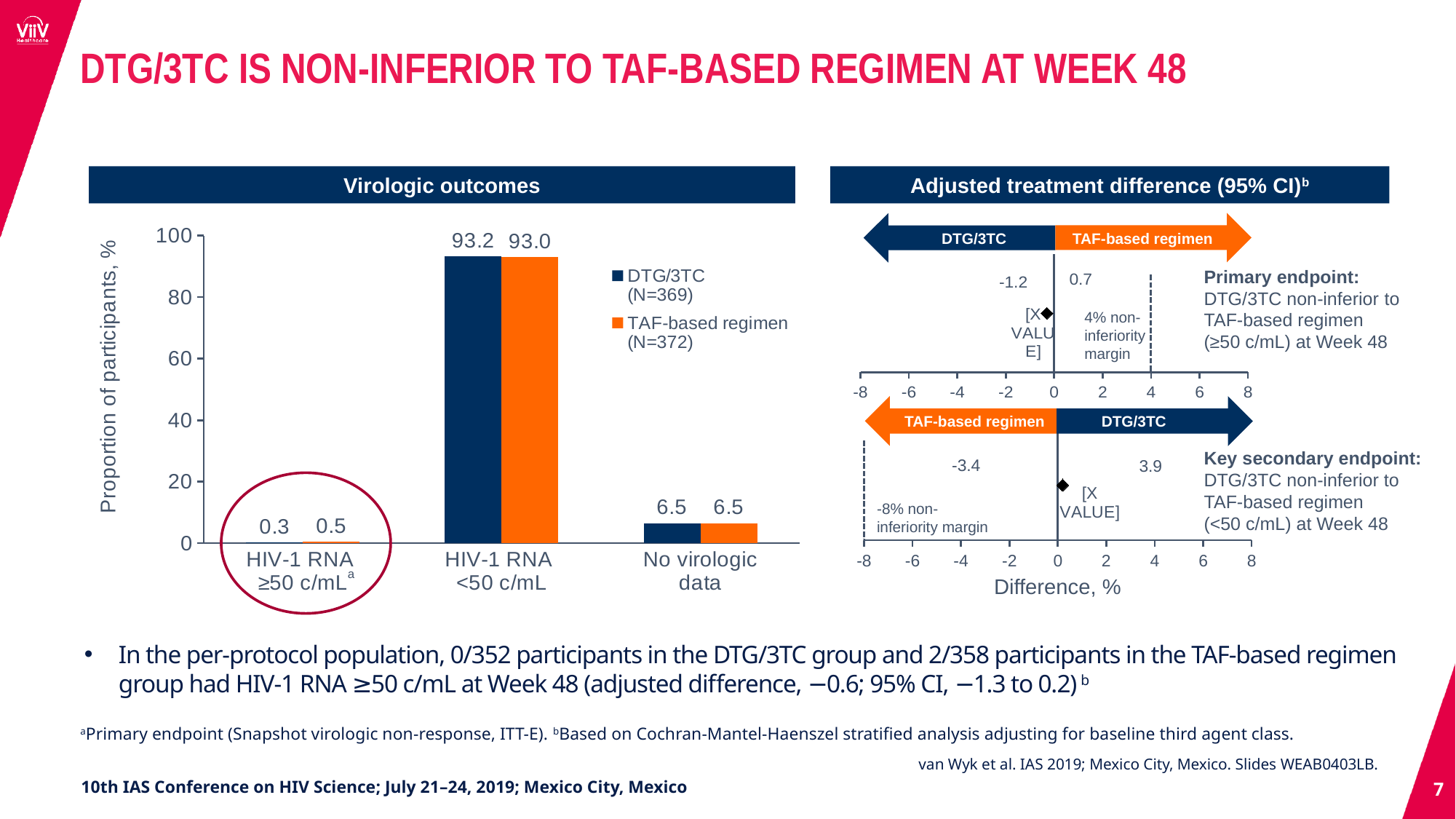
In the Virologic outcomes chart, what is the value for the TAF-based regimen in the HIV-1 RNA ≥50 c/mL category? 0.5 In the Virologic outcomes chart, what is the value for the TAF-based regimen in the No virologic data category? 6.5 In the Virologic outcomes chart, what is the value for DTG/3TC in the HIV-1 RNA <50 c/mL category? 93.2 What is the y-axis title of the Virologic outcomes chart? Proportion of participants, % How many categories are shown on the x axis of the Virologic outcomes chart? 3 In the Virologic outcomes chart, which category has the highest value for DTG/3TC? HIV-1 RNA <50 c/mL How many series does the legend of the Virologic outcomes chart list? 2 In the Virologic outcomes chart, which series has the larger value for HIV-1 RNA ≥50 c/mL? TAF-based regimen In the Virologic outcomes chart, what is the difference between the DTG/3TC and TAF-based regimen values for HIV-1 RNA <50 c/mL? 0.2 In the Virologic outcomes chart, which category has the lowest value for the TAF-based regimen? HIV-1 RNA ≥50 c/mL What kind of chart is the Virologic outcomes chart? Bar chart In the Adjusted treatment difference chart, what is the upper confidence limit printed for the primary endpoint? 0.7